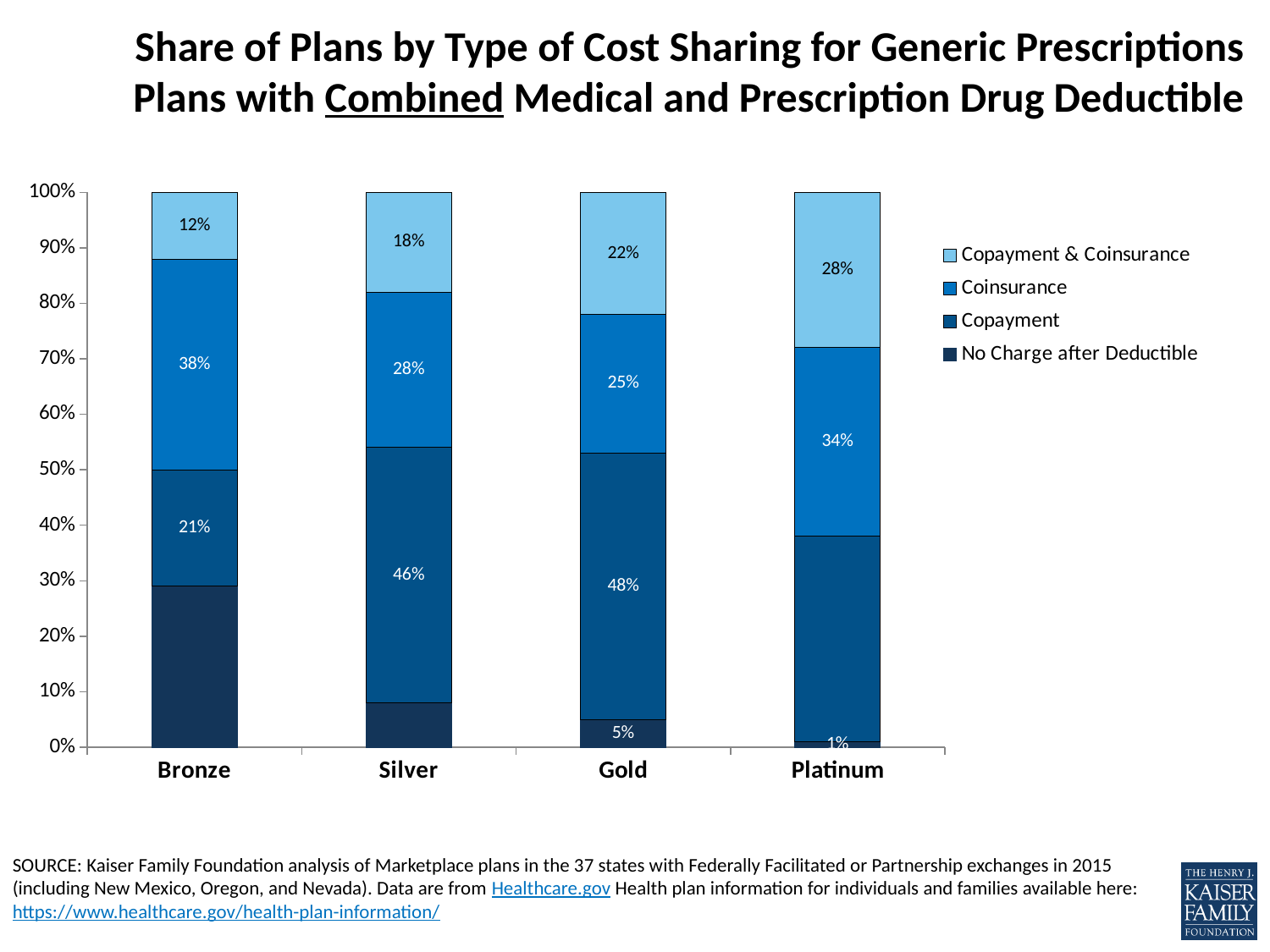
Among the labeled Copayment values, which metal level has the lowest Copayment share? Bronze Which metal level has the highest Copayment & Coinsurance share? Platinum Is the Copayment share for Platinum plans greater or less than 30%? greater What share of Bronze plans have Coinsurance cost sharing for generic prescriptions? 38% What is the Copayment & Coinsurance share for Silver plans? 18% What share of Platinum plans have No Charge after Deductible? 1% Is the No Charge after Deductible share for Silver plans greater or less than 10%? less What is the difference between the Coinsurance share for Bronze and for Gold plans? 13% Which is larger: the Copayment share for Silver or for Gold plans? Gold What is the Copayment share for Gold plans? 48% How many metal levels are shown on the x axis? 4 Does the Copayment & Coinsurance share rise or fall from Bronze to Platinum? rise